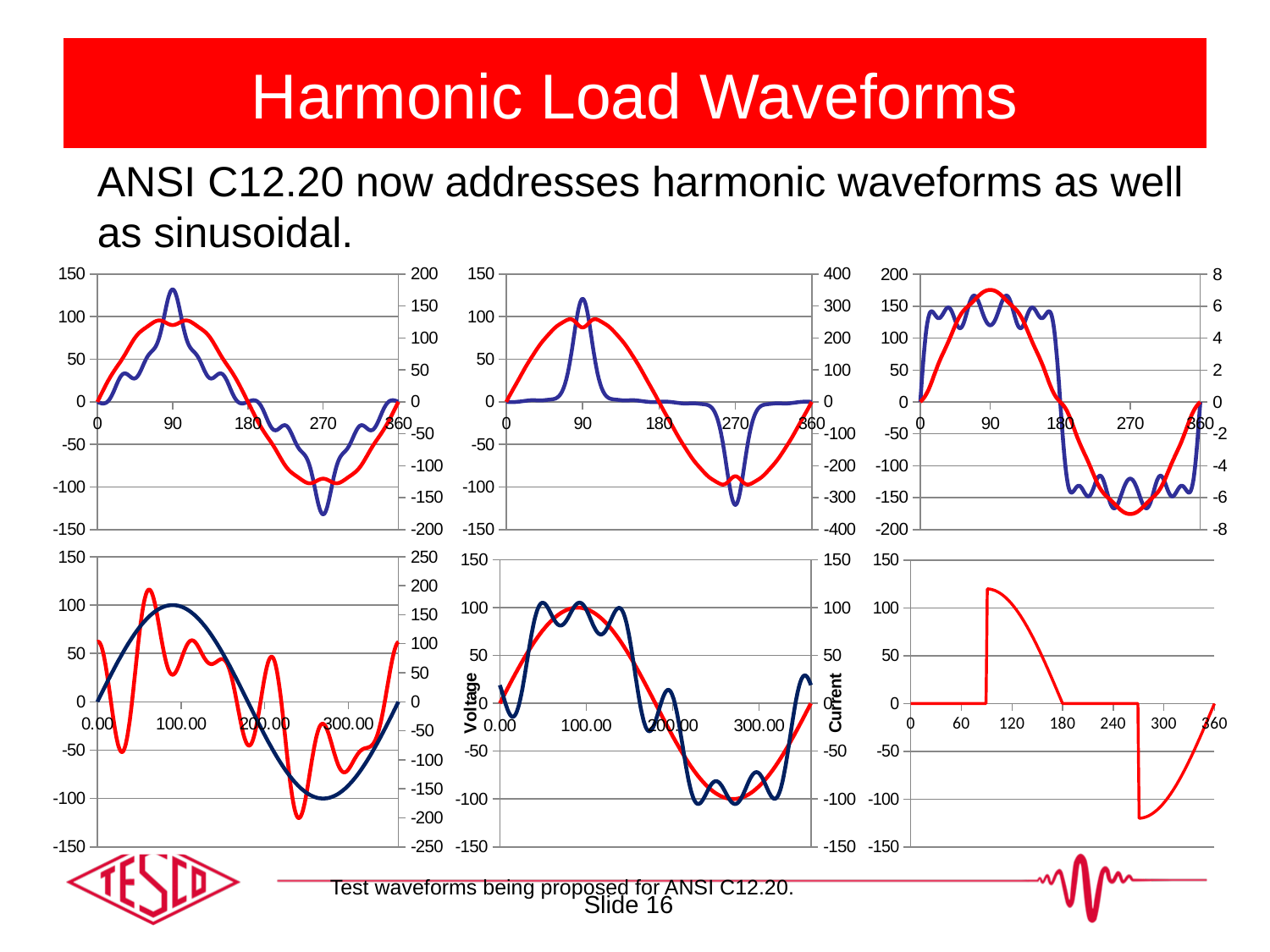
How many lines are plotted in the bottom-right chart? 1 How many charts are shown on the slide? 6 What kind of chart is the top-left chart on the slide? line chart In the top-right chart, is the peak of the red line greater or less than 150 on the left axis? greater In the bottom-middle chart, what is the label on the left vertical axis? Voltage In the top-middle chart, what is the maximum value shown on the right vertical axis? 400 How many lines are plotted in the bottom-left chart? 2 In the top-right chart, what is the maximum value shown on the right vertical axis? 8 In the bottom-right chart, does the red line rise or fall between x = 120 and x = 180? fall In the bottom-right chart, is the peak value of the red line greater or less than 100? greater In the bottom-right chart, is the value of the red line at x = 240 greater or less than 50? less In the bottom-middle chart, what is the label on the right vertical axis? Current